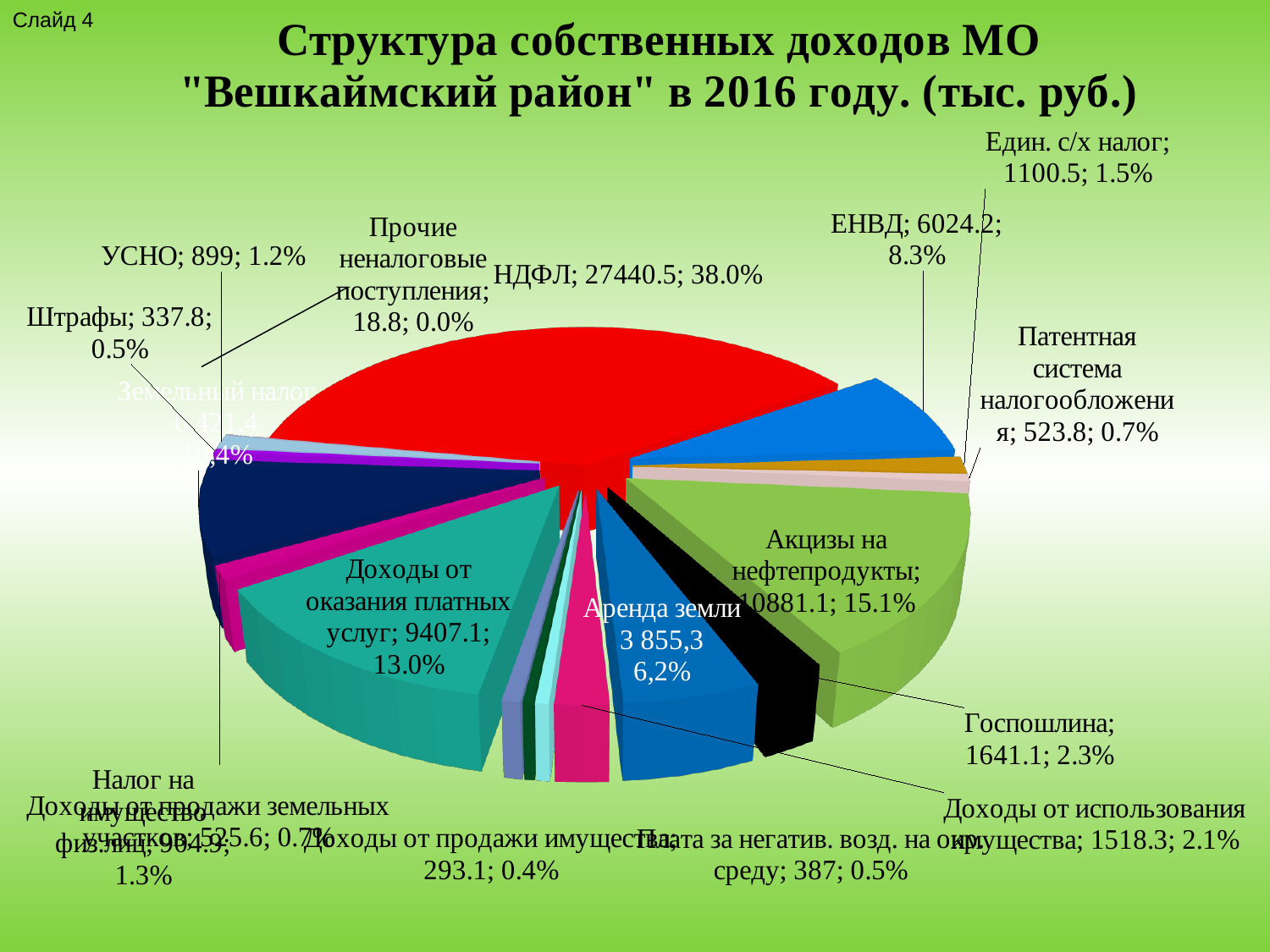
Which is larger, ЕНВД or Един. с/х налог? ЕНВД What is the value for Госпошлина? 1641.1 What is the value for УСНО? 899 What is the value for НДФЛ? 27440.5 What share of the pie does Акцизы на нефтепродукты have? 15.1% What is the value for ЕНВД? 6024.2 What share of the pie does Прочие неналоговые поступления have? 0.0% Which category has the largest share of the pie? НДФЛ What kind of chart is shown on the slide? pie chart What is the difference between the values for Акцизы на нефтепродукты and Доходы от оказания платных услуг? 1474 What share of the pie does Доходы от оказания платных услуг have? 13.0% What is the title of the chart? Структура собственных доходов МО "Вешкаймский район" в 2016 году. (тыс. руб.)